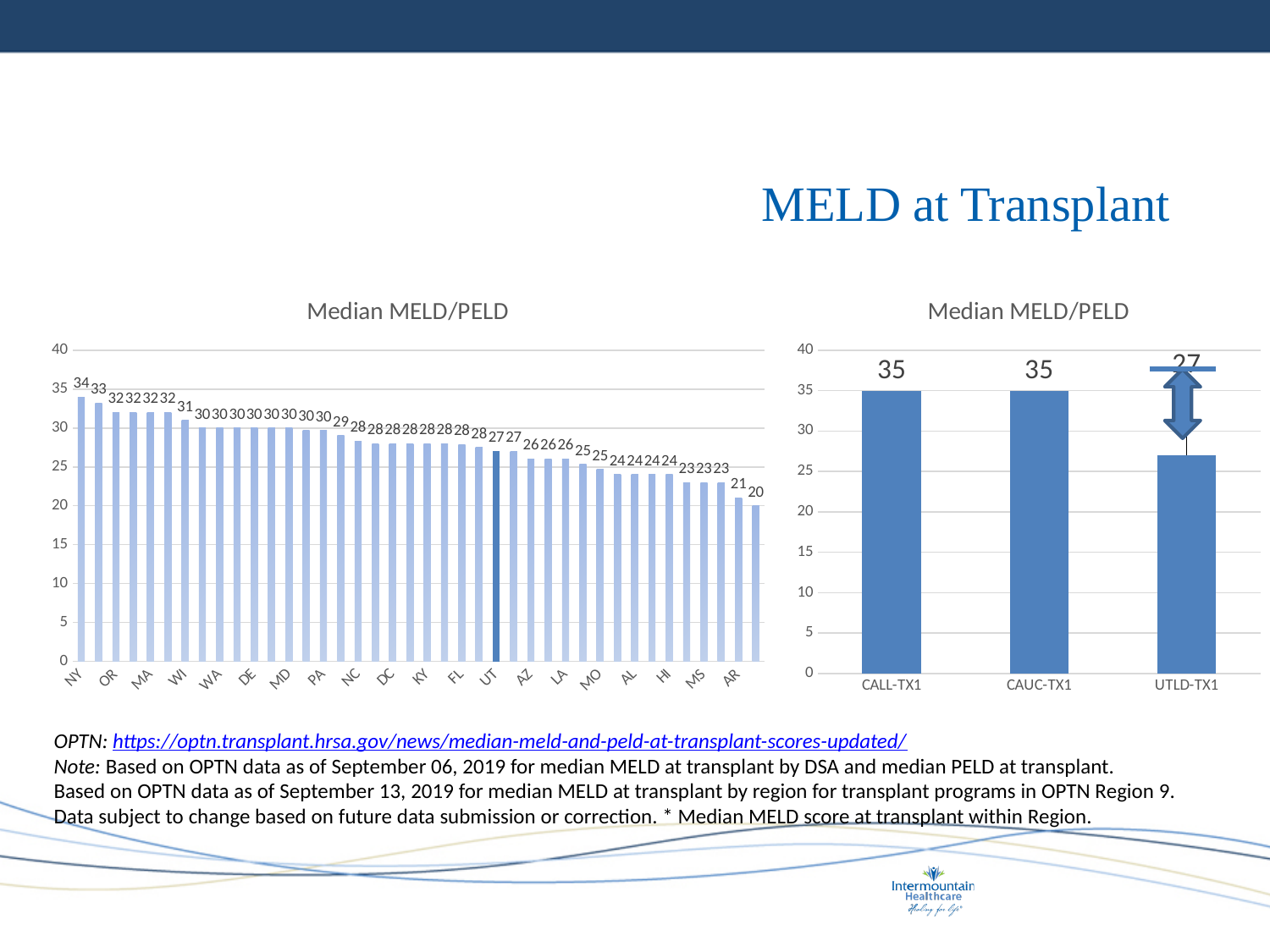
In the left chart, what is the value for NY? 34 In the right chart, what is the value for UTLD-TX1? 27 In the left chart, which category has the highest value? NY In the right chart, what is the value for CALL-TX1? 35 In the left chart, what is the difference between the values for NY and AR? 13 How many categories are shown in the right chart? 3 What kind of chart is the right chart? bar chart In the left chart, what is the value for OR? 32 In the left chart, do the values rise or fall moving from left to right along the x axis? fall In the right chart, what is the difference between the values for CALL-TX1 and UTLD-TX1? 8 In the right chart, which is larger, the value for CAUC-TX1 or the value for UTLD-TX1? CAUC-TX1